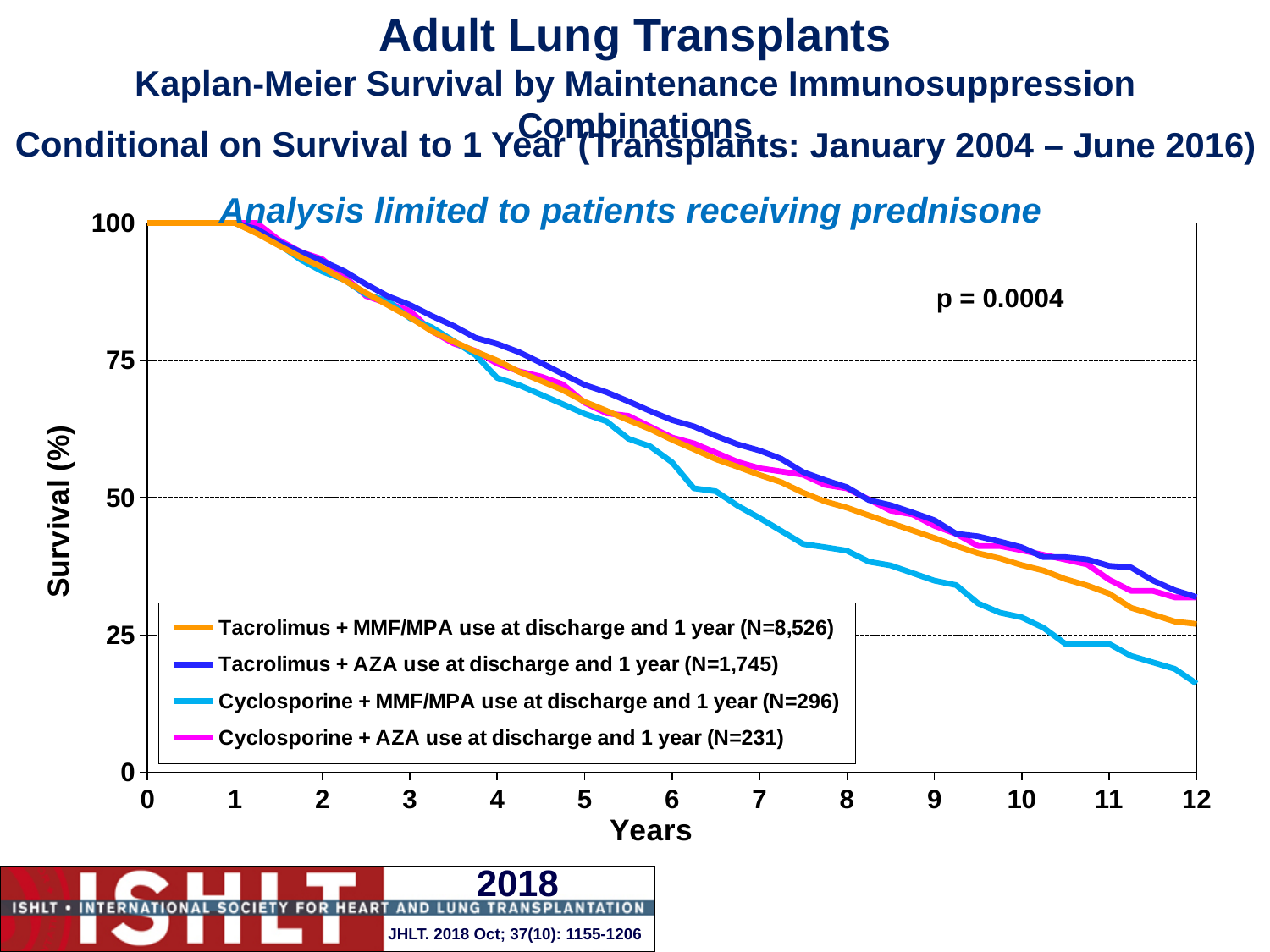
At 12 years, which has higher survival: Tacrolimus + AZA or Cyclosporine + MMF/MPA? Tacrolimus + AZA Do the survival curves rise or fall as years increase? fall How many series does the legend list? 4 Is the survival value for Cyclosporine + MMF/MPA at 12 years greater or less than 25? less What type of chart is shown on the slide? line chart What is the N for the Cyclosporine + AZA use at discharge and 1 year group? N=231 What is the N for the Tacrolimus + MMF/MPA use at discharge and 1 year group? N=8,526 Is the survival value for Cyclosporine + AZA at 10 years greater or less than 50? less Is the survival value for Tacrolimus + MMF/MPA at 6 years greater or less than 50? greater Which group has the lowest survival at 12 years? Cyclosporine + MMF/MPA use at discharge and 1 year What p-value is printed on the chart? p = 0.0004